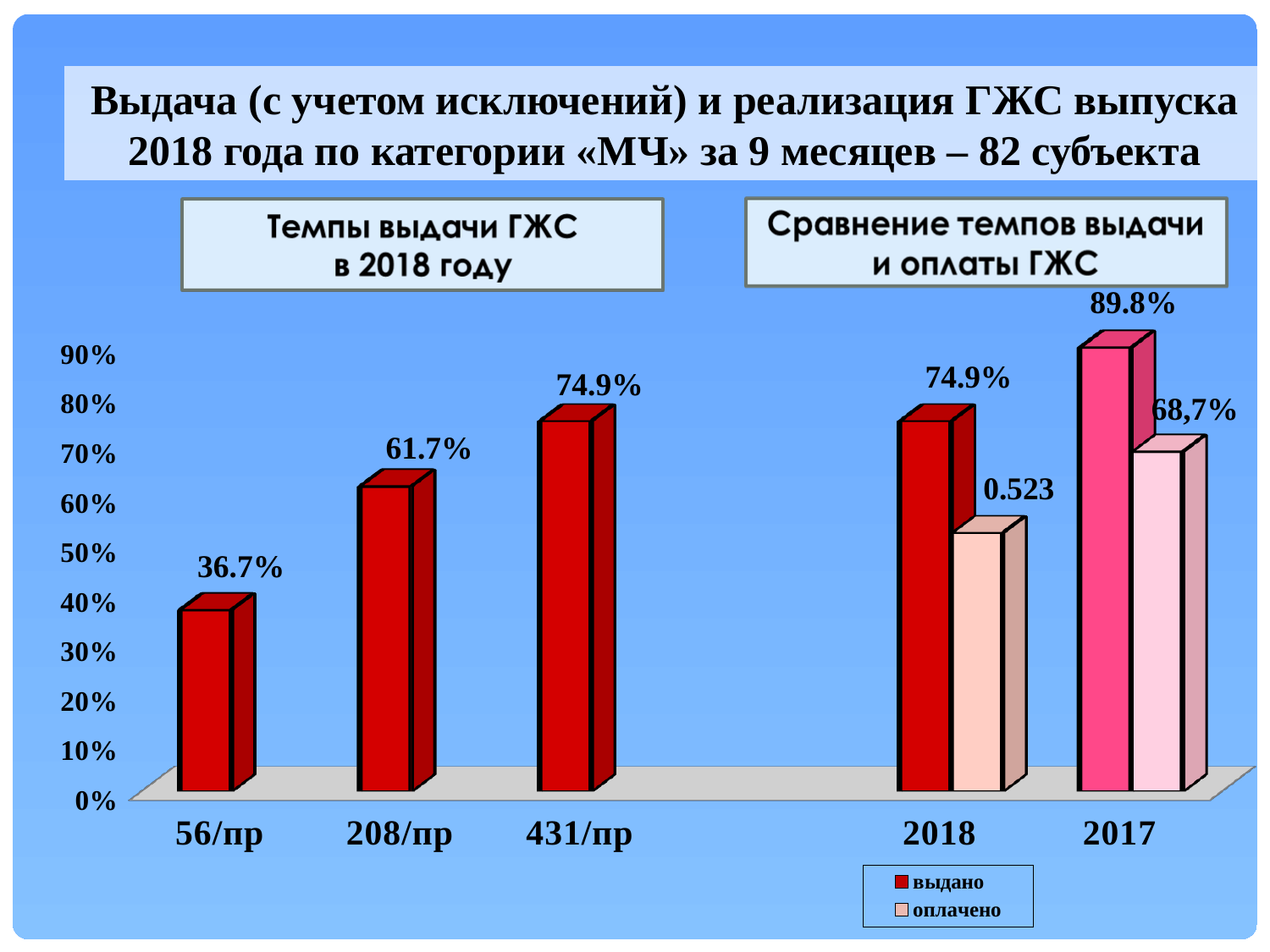
In the chart 'Темпы выдачи ГЖС в 2018 году', do the values rise or fall from 56/пр to 431/пр? rise In the chart 'Темпы выдачи ГЖС в 2018 году', what is the value for 208/пр? 61.7% What kind of chart is used on this slide? bar chart In the chart 'Сравнение темпов выдачи и оплаты ГЖС', which year has the larger 'выдано' value, 2018 or 2017? 2017 In the chart 'Темпы выдачи ГЖС в 2018 году', which category has the lowest value? 56/пр In the chart 'Сравнение темпов выдачи и оплаты ГЖС', how many series does the legend list? 2 In the chart 'Темпы выдачи ГЖС в 2018 году', what is the difference between the values for 431/пр and 56/пр? 38.2% In the chart 'Темпы выдачи ГЖС в 2018 году', which category has the highest value? 431/пр In the chart 'Сравнение темпов выдачи и оплаты ГЖС', what is the 'выдано' value for 2017? 89.8% In the chart 'Сравнение темпов выдачи и оплаты ГЖС', what is the 'оплачено' value for 2018? 0.523 In the chart 'Темпы выдачи ГЖС в 2018 году', what is the value for 56/пр? 36.7% In the chart 'Темпы выдачи ГЖС в 2018 году', how many categories are shown? 3